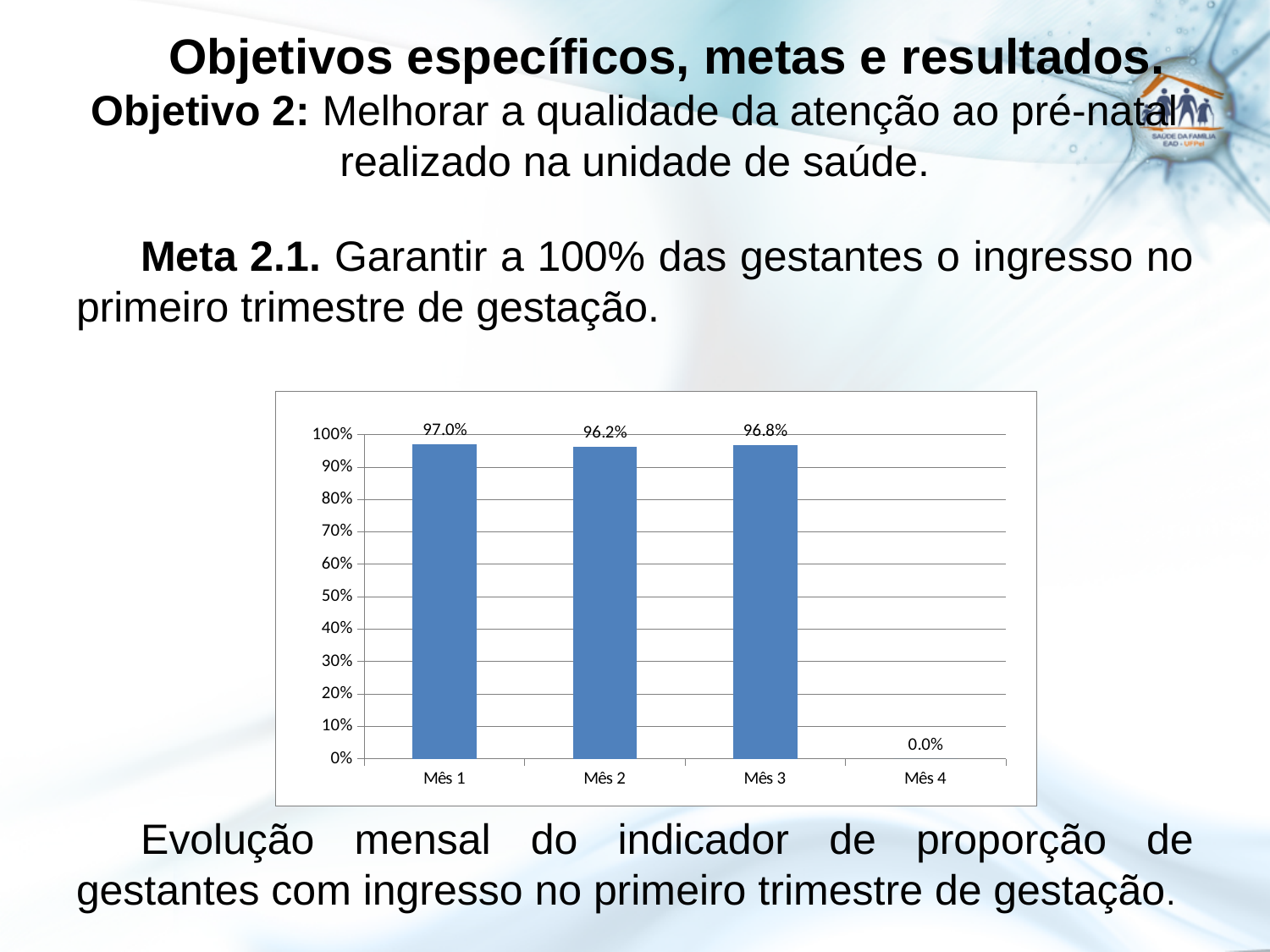
What kind of chart is shown on the slide? bar chart How many months are shown on the x axis? 4 Is the value for Mês 2 greater or less than 90%? greater Which month has the lowest value? Mês 4 What is the value for Mês 2? 96.2% Which is larger, the value for Mês 2 or the value for Mês 3? Mês 3 Which month has the highest value? Mês 1 What is the value for Mês 4? 0.0% Does the value rise or fall from Mês 1 to Mês 2? fall What is the value for Mês 3? 96.8% What is the difference between the values for Mês 1 and Mês 2? 0.8 percentage points What is the value for Mês 1? 97.0%